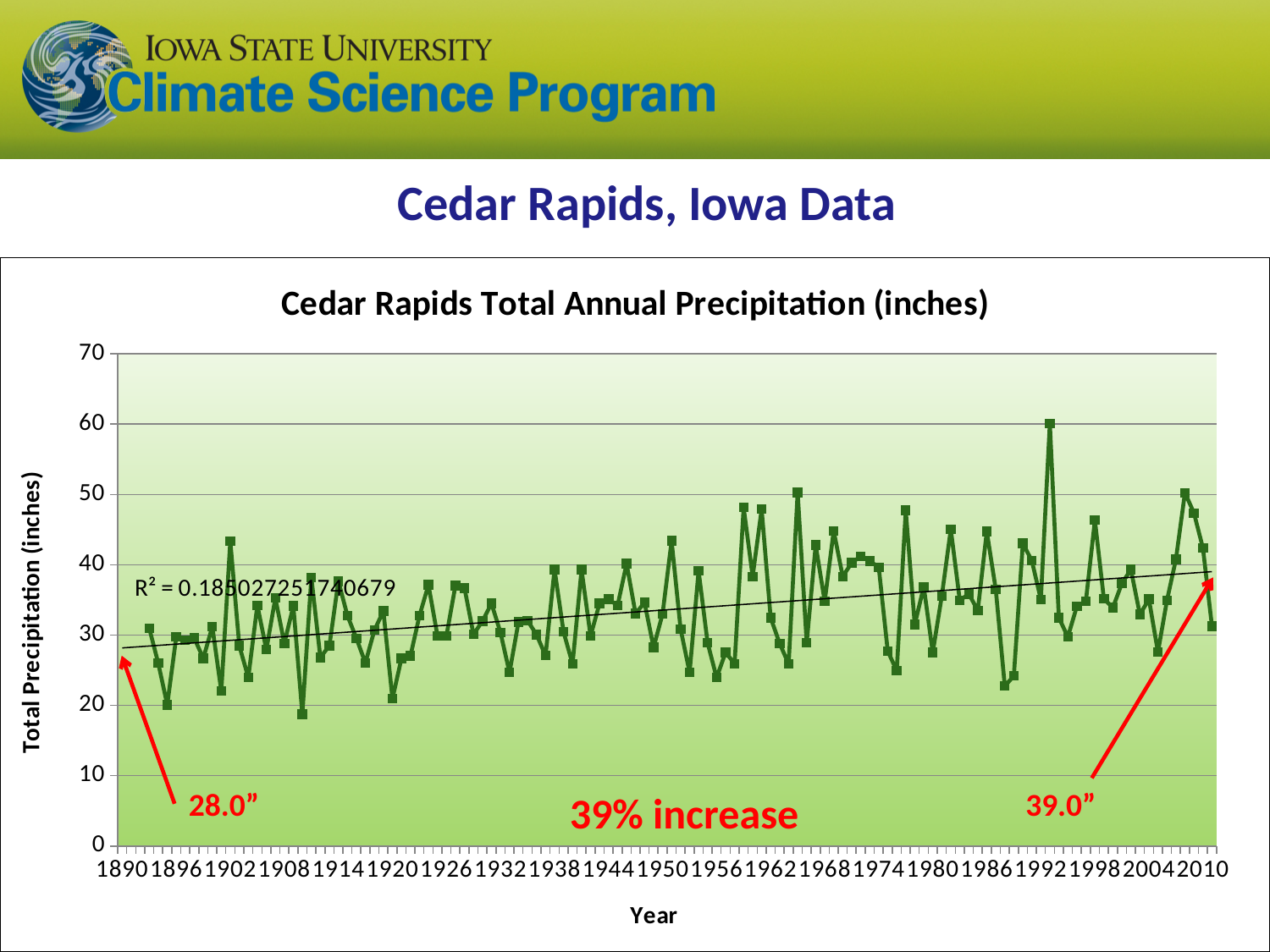
Is the lowest plotted precipitation value (around 1910) greater or less than 25 inches? less What is the title of the chart? Cedar Rapids Total Annual Precipitation (inches) What is the label of the y axis? Total Precipitation (inches) What kind of chart is shown on the slide? Line chart What percentage increase is annotated on the chart? 39% increase What value is annotated at the end of the trend line (around 2010)? 39.0" What value is annotated at the start of the trend line (around 1890)? 28.0" What R² value is printed on the chart? R² = 0.185027251740679 What is the maximum value shown on the y axis? 70 What is the first year shown on the x axis? 1890 Is the highest plotted precipitation value (around 1993) greater or less than 50 inches? greater According to the trend line, does total annual precipitation rise or fall from 1890 to 2010? Rise